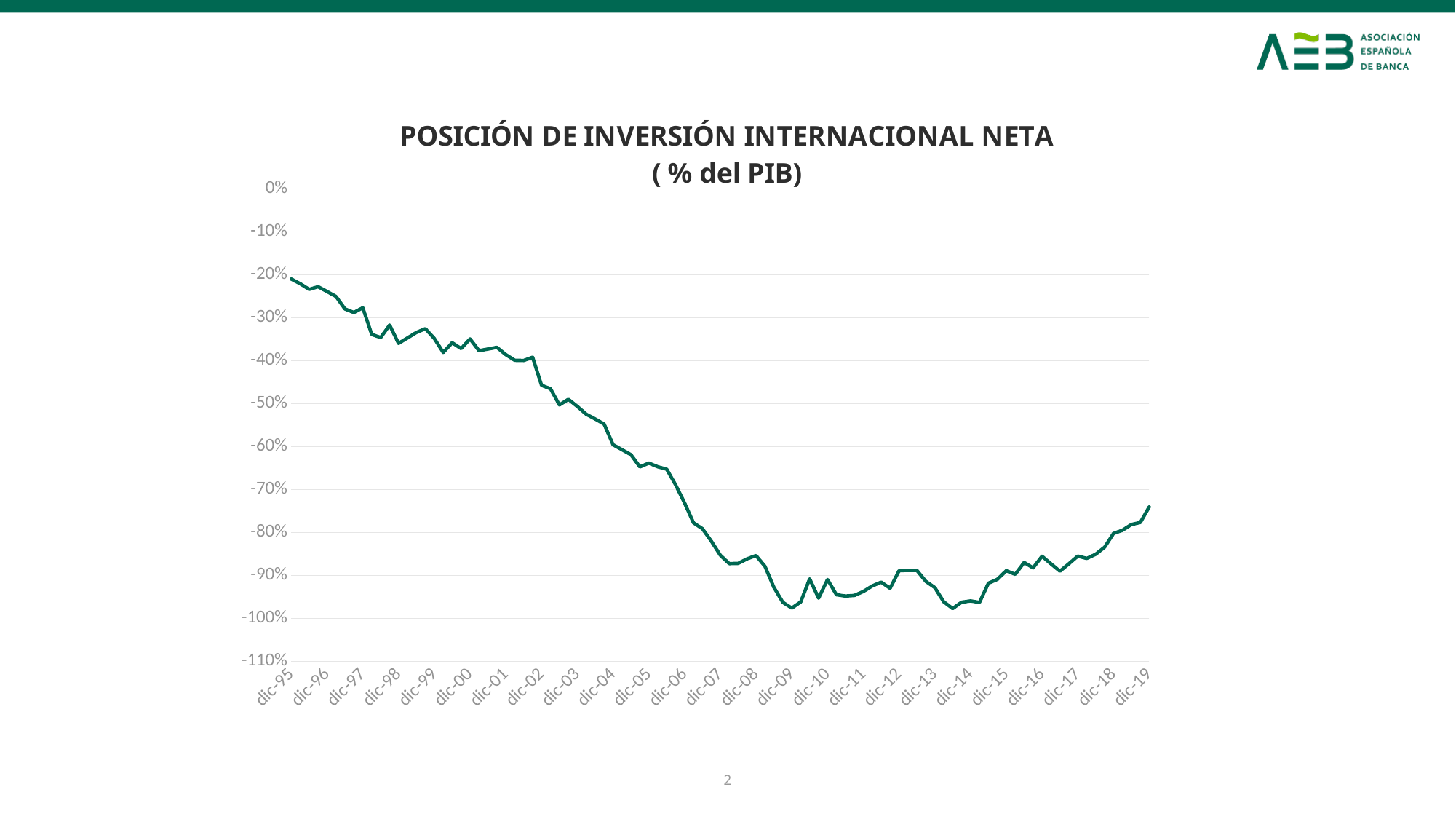
Is the value at dic-09 greater or less than -90%? less Which is larger, the value at dic-95 or the value at dic-09? dic-95 What kind of chart is shown on the slide? line chart Is the value at dic-00 greater or less than -40%? greater Does the line rise or fall from dic-14 to dic-19? rise What is the title of the chart? POSICIÓN DE INVERSIÓN INTERNACIONAL NETA ( % del PIB) Is the value at dic-95 greater or less than -30%? greater How many date labels are shown on the x axis? 25 Does the line rise or fall from dic-95 to dic-09? fall Which is larger, the value at dic-19 or the value at dic-09? dic-19 Which x-axis label has the highest (least negative) value on the line? dic-95